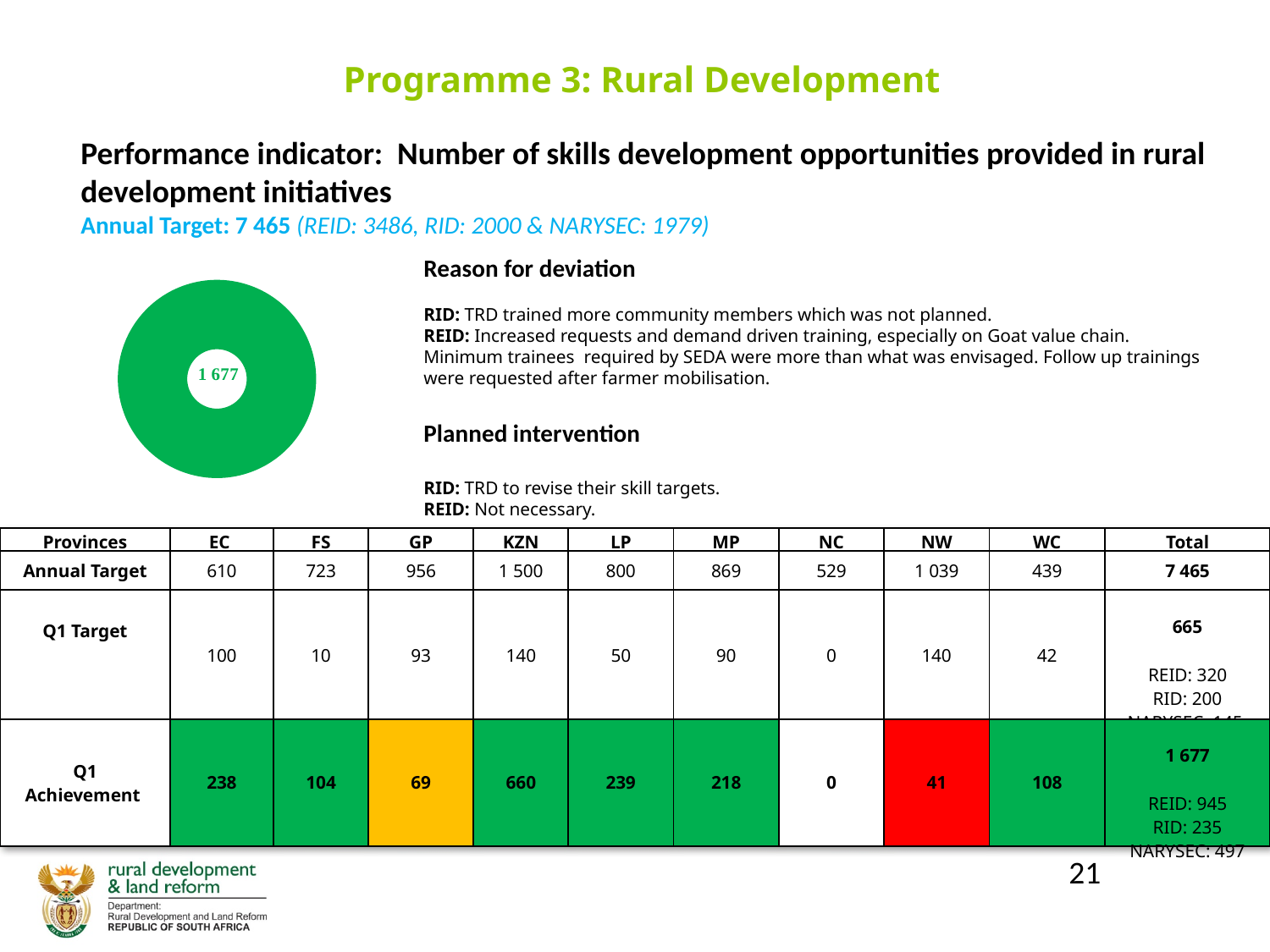
What kind of chart is shown on the left of the slide? doughnut chart How many distinct slices are visible in the doughnut chart? 1 What colour is the ring of the doughnut chart? green Does the doughnut chart display a legend? No What value is printed in the centre of the doughnut chart? 1 677